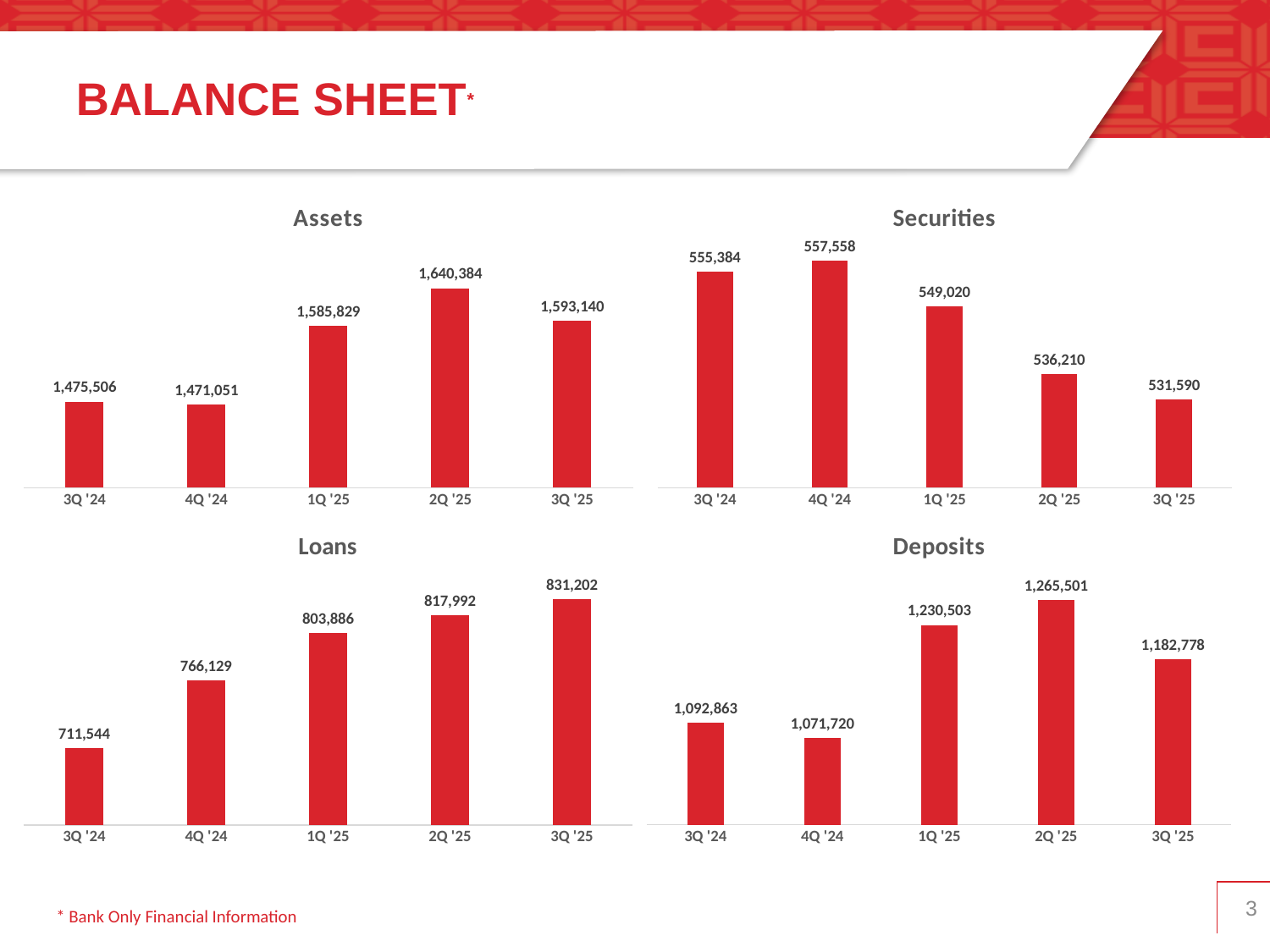
In the Deposits chart, how much higher is the 2Q '25 value than the 3Q '25 value? 82,723 In the Assets chart, which quarter has the highest value? 2Q '25 How many quarters are shown in the Loans chart? 5 In the Securities chart, which quarter has the lowest value? 3Q '25 In the Deposits chart, what is the value for 3Q '25? 1,182,778 In the Deposits chart, which is larger, the value for 3Q '24 or 4Q '24? 3Q '24 In the Loans chart, what is the value for 4Q '24? 766,129 In the Loans chart, do the values rise or fall from 3Q '24 to 3Q '25? Rise In the Loans chart, what is the difference between the 3Q '25 and 3Q '24 values? 119,658 What type of chart is the Securities chart? Bar chart In the Assets chart, what is the value for 2Q '25? 1,640,384 In the Securities chart, what is the value for 1Q '25? 549,020